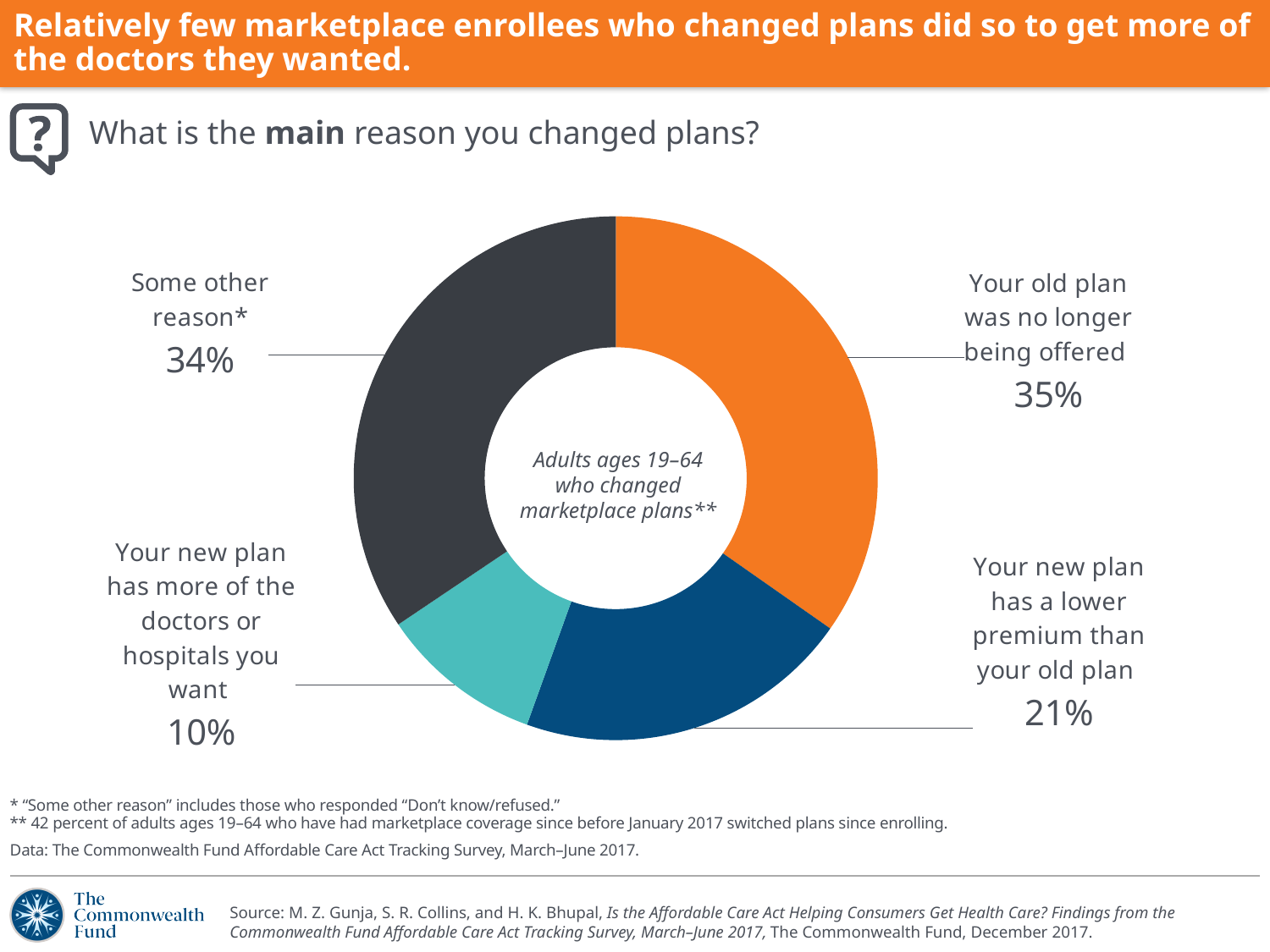
Which reason for changing plans has the largest share? Your old plan was no longer being offered Which is larger: the share for 'Some other reason' or the share for 'Your new plan has a lower premium than your old plan'? Some other reason What percentage gave some other reason for changing plans? 34% What type of chart is shown on the slide? Pie chart (donut) What is the combined share of 'Your old plan was no longer being offered' and 'Some other reason'? 69% How many percentage points higher is 'Your new plan has a lower premium than your old plan' than 'Your new plan has more of the doctors or hospitals you want'? 11 percentage points Which reason for changing plans has the smallest share? Your new plan has more of the doctors or hospitals you want What population does the text in the center of the chart say is represented? Adults ages 19–64 who changed marketplace plans What percentage of adults who changed marketplace plans said their old plan was no longer being offered? 35% How many reasons (slices) are shown in the chart? 4 What share of respondents changed plans because the new plan has a lower premium than the old plan? 21% What percentage changed plans because the new plan has more of the doctors or hospitals they want? 10%